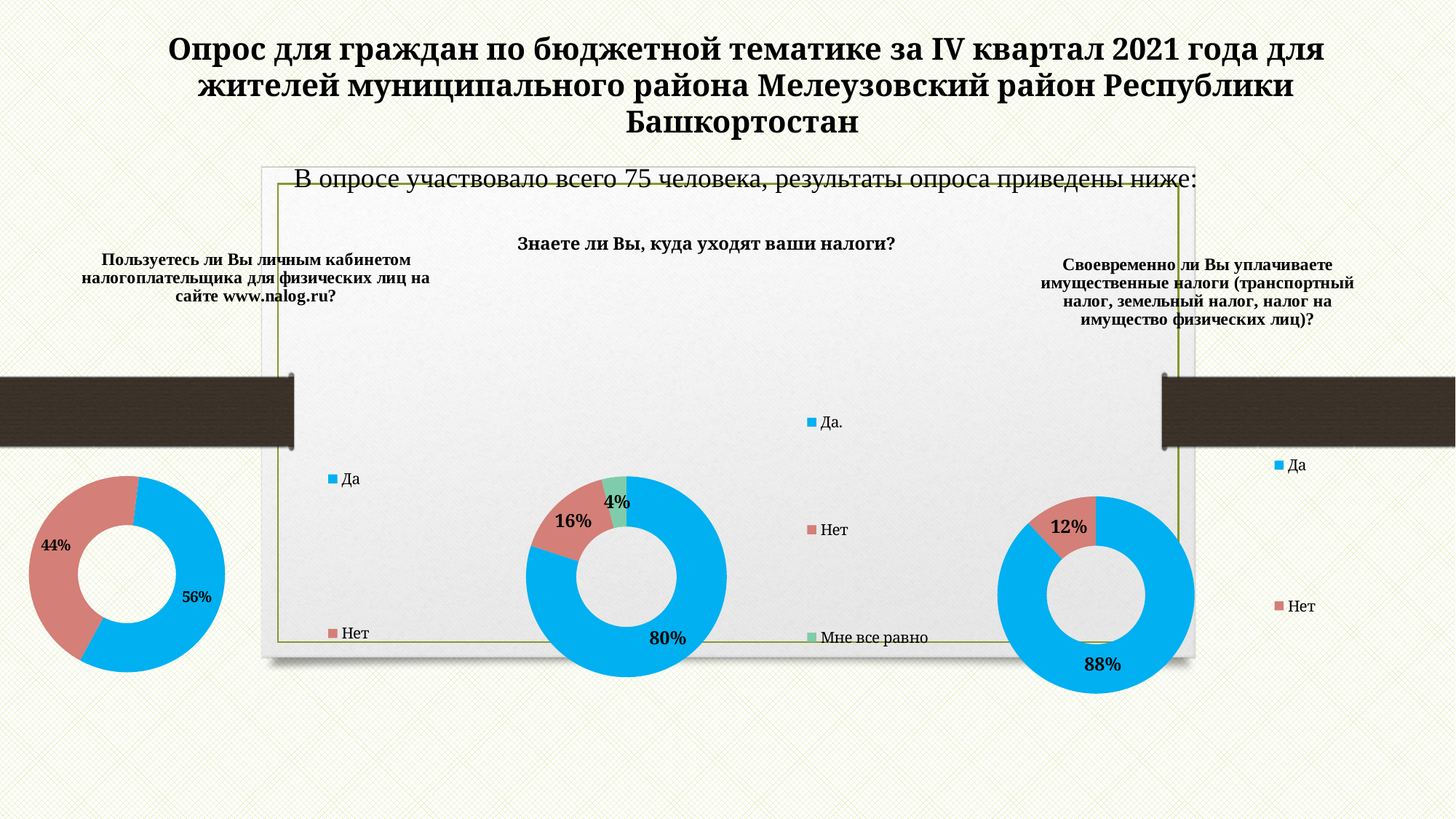
In the middle chart ("Знаете ли Вы, куда уходят ваши налоги?"), what share answered "Нет"? 16% How many charts are shown on the slide? 3 In the middle chart ("Знаете ли Вы, куда уходят ваши налоги?"), what share answered "Мне все равно"? 4% What type of chart is the right chart ("Своевременно ли Вы уплачиваете имущественные налоги...")? Doughnut chart In the middle chart ("Знаете ли Вы, куда уходят ваши налоги?"), which answer has the largest share? Да. In the middle chart ("Знаете ли Вы, куда уходят ваши налоги?"), which answer has the smallest share? Мне все равно In the left chart ("Пользуетесь ли Вы личным кабинетом налогоплательщика..."), which answer is larger, "Да" or "Нет"? Да In the left chart ("Пользуетесь ли Вы личным кабинетом налогоплательщика..."), what share answered "Да"? 56% In the right chart ("Своевременно ли Вы уплачиваете имущественные налоги..."), what share answered "Да"? 88% In the left chart ("Пользуетесь ли Вы личным кабинетом налогоплательщика..."), what share answered "Нет"? 44% How many answer categories does the legend of the middle chart ("Знаете ли Вы, куда уходят ваши налоги?") list? 3 In the right chart ("Своевременно ли Вы уплачиваете имущественные налоги..."), what is the difference in percentage points between "Да" and "Нет"? 76